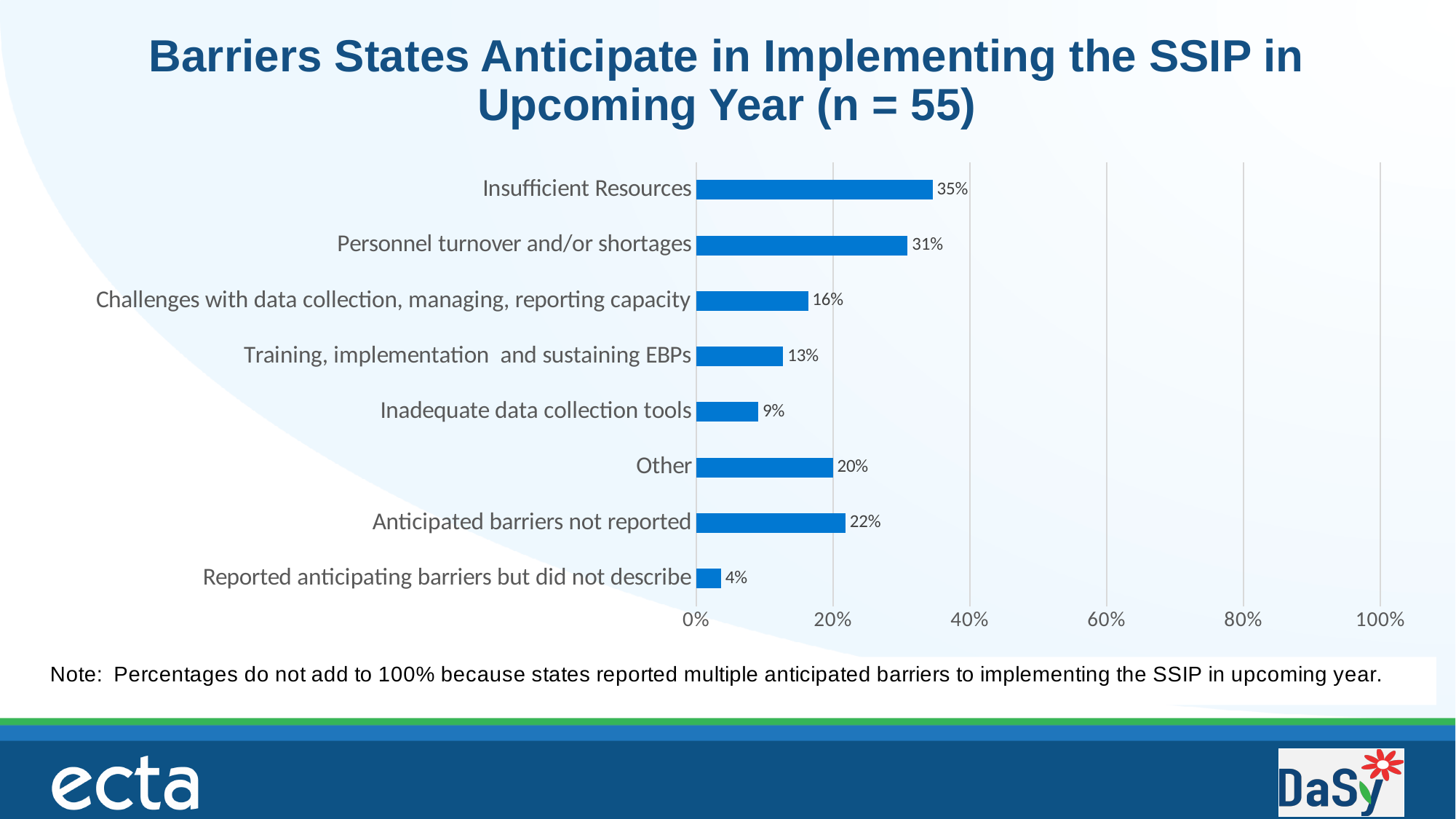
What percentage of states anticipate Insufficient Resources as a barrier? 35% What is the value for Reported anticipating barriers but did not describe? 4% How many categories are shown in the chart? 8 Which barrier has the highest percentage? Insufficient Resources What type of chart is shown on the slide? bar chart What is the value for Personnel turnover and/or shortages? 31% What percentage is shown for Inadequate data collection tools? 9% What is the title of the chart? Barriers States Anticipate in Implementing the SSIP in Upcoming Year (n = 55) Is the value for Challenges with data collection, managing, reporting capacity greater or less than 20%? less Which category has the lowest percentage? Reported anticipating barriers but did not describe What is the difference between Insufficient Resources and Personnel turnover and/or shortages? 4% Which is larger: Other or Anticipated barriers not reported? Anticipated barriers not reported